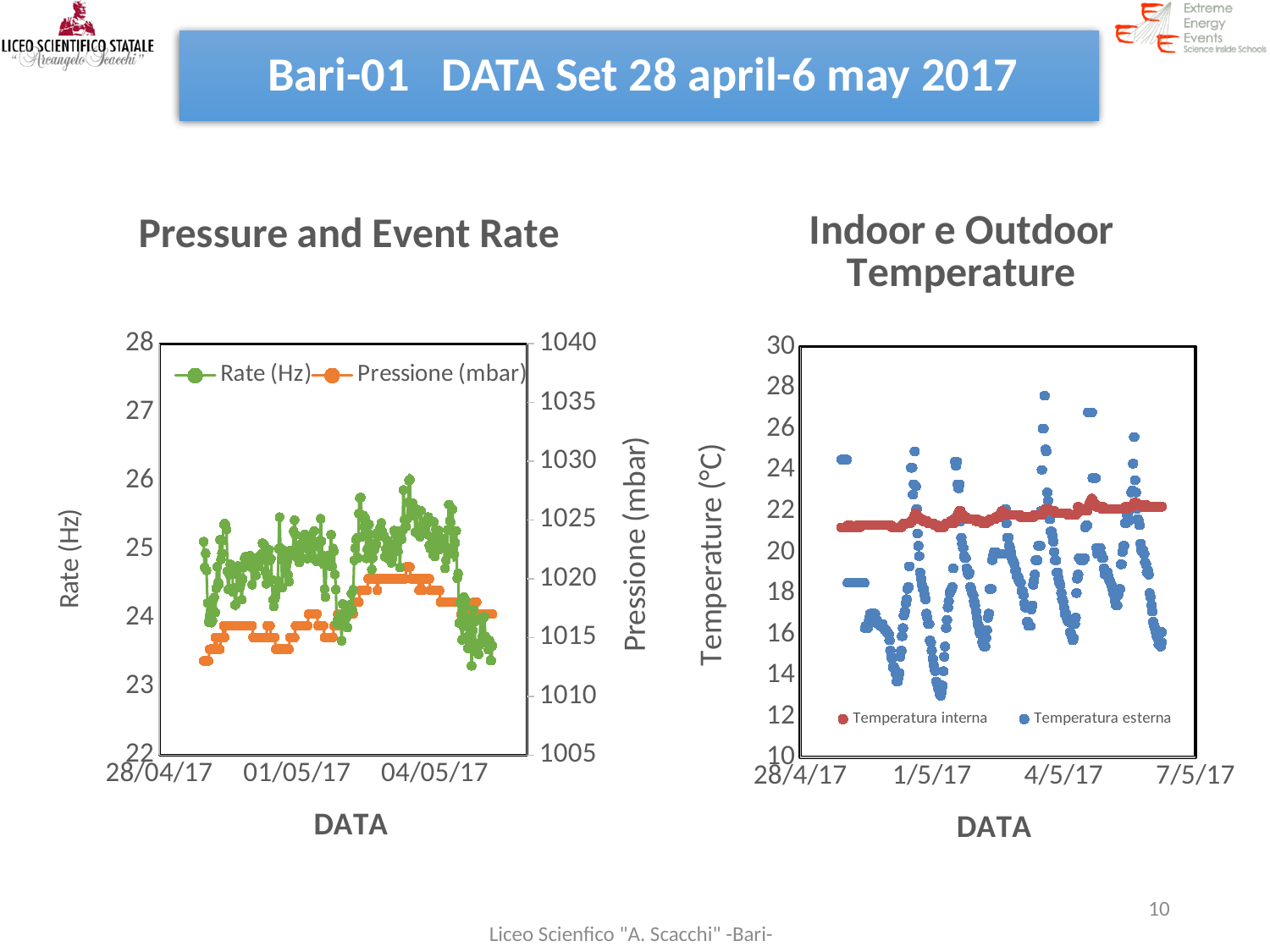
In the 'Pressure and Event Rate' chart, how many series does the legend list? 2 In the 'Indoor e Outdoor Temperature' chart, which series shows the larger spread of values, Temperatura interna or Temperatura esterna? Temperatura esterna In the 'Pressure and Event Rate' chart, what are the two series named in the legend? Rate (Hz) and Pressione (mbar) In the 'Indoor e Outdoor Temperature' chart, how many series does the legend list? 2 In the 'Pressure and Event Rate' chart, what is the title of the right-hand vertical axis? Pressione (mbar) In the 'Indoor e Outdoor Temperature' chart, is the highest Temperatura interna value greater or less than 24? less What kind of chart is the 'Pressure and Event Rate' chart? line chart In the 'Indoor e Outdoor Temperature' chart, is the lowest Temperatura esterna value greater or less than 14? less In the 'Indoor e Outdoor Temperature' chart, is the highest Temperatura esterna value greater or less than 26? greater